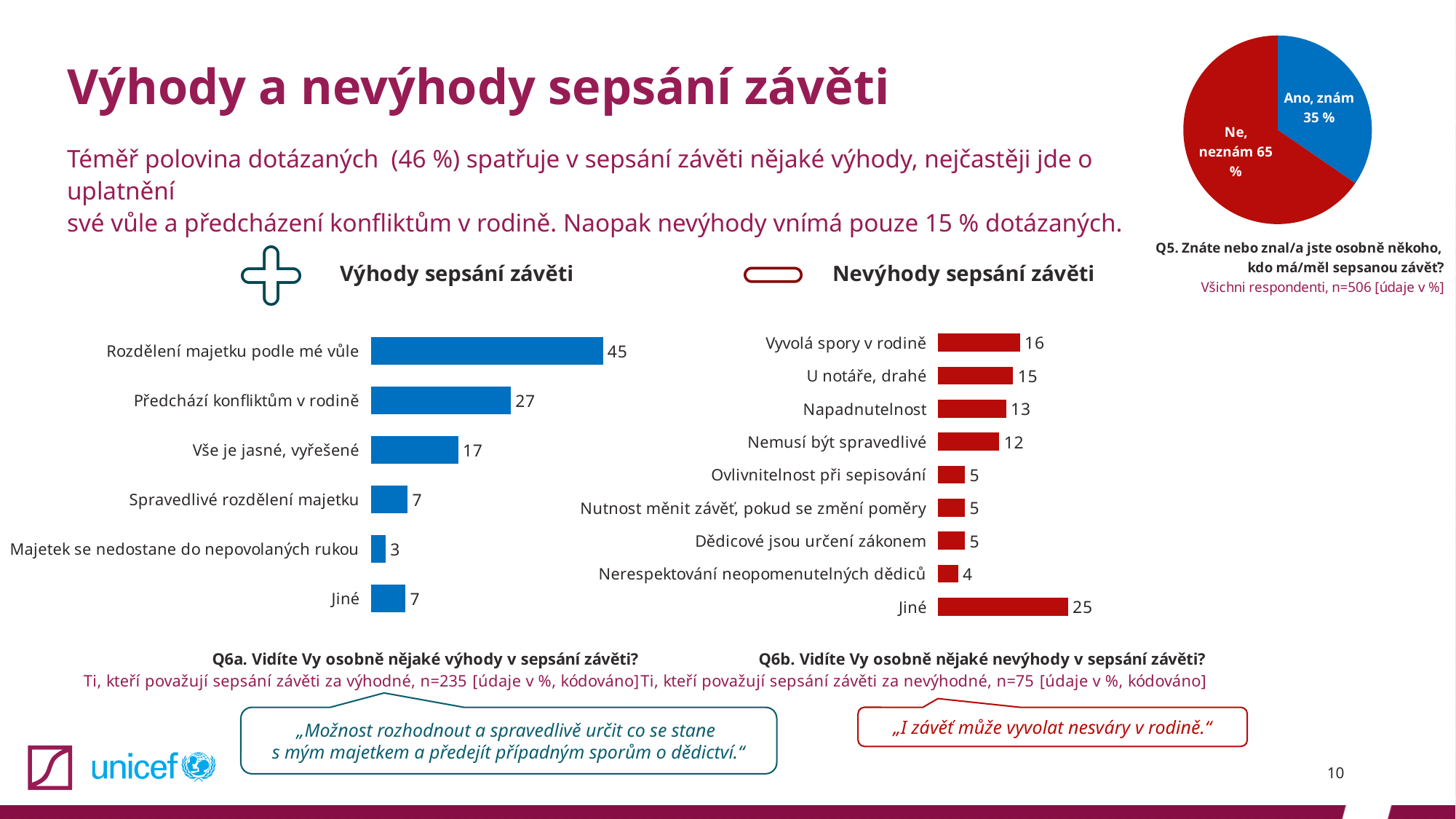
How many categories are shown in the 'Nevýhody sepsání závěti' chart? 9 What type of chart is the 'Výhody sepsání závěti' chart? Bar chart In the 'Nevýhody sepsání závěti' chart, which category has the highest value? Jiné In the 'Nevýhody sepsání závěti' chart, what is the value for 'Napadnutelnost'? 13 In the 'Nevýhody sepsání závěti' chart, which is larger: 'Vyvolá spory v rodině' or 'Nemusí být spravedlivé'? Vyvolá spory v rodině In the 'Nevýhody sepsání závěti' chart, what is the difference between 'Jiné' and 'U notáře, drahé'? 10 How many categories are shown in the 'Výhody sepsání závěti' chart? 6 In the 'Výhody sepsání závěti' chart, what is the value for 'Rozdělení majetku podle mé vůle'? 45 In the 'Výhody sepsání závěti' chart, which category has the lowest value? Majetek se nedostane do nepovolaných rukou In the pie chart at the top right, which slice is larger: 'Ano, znám' or 'Ne, neznám'? Ne, neznám In the pie chart at the top right, what share is labelled 'Ano, znám'? 35 % In the 'Výhody sepsání závěti' chart, what is the difference between 'Rozdělení majetku podle mé vůle' and 'Předchází konfliktům v rodině'? 18